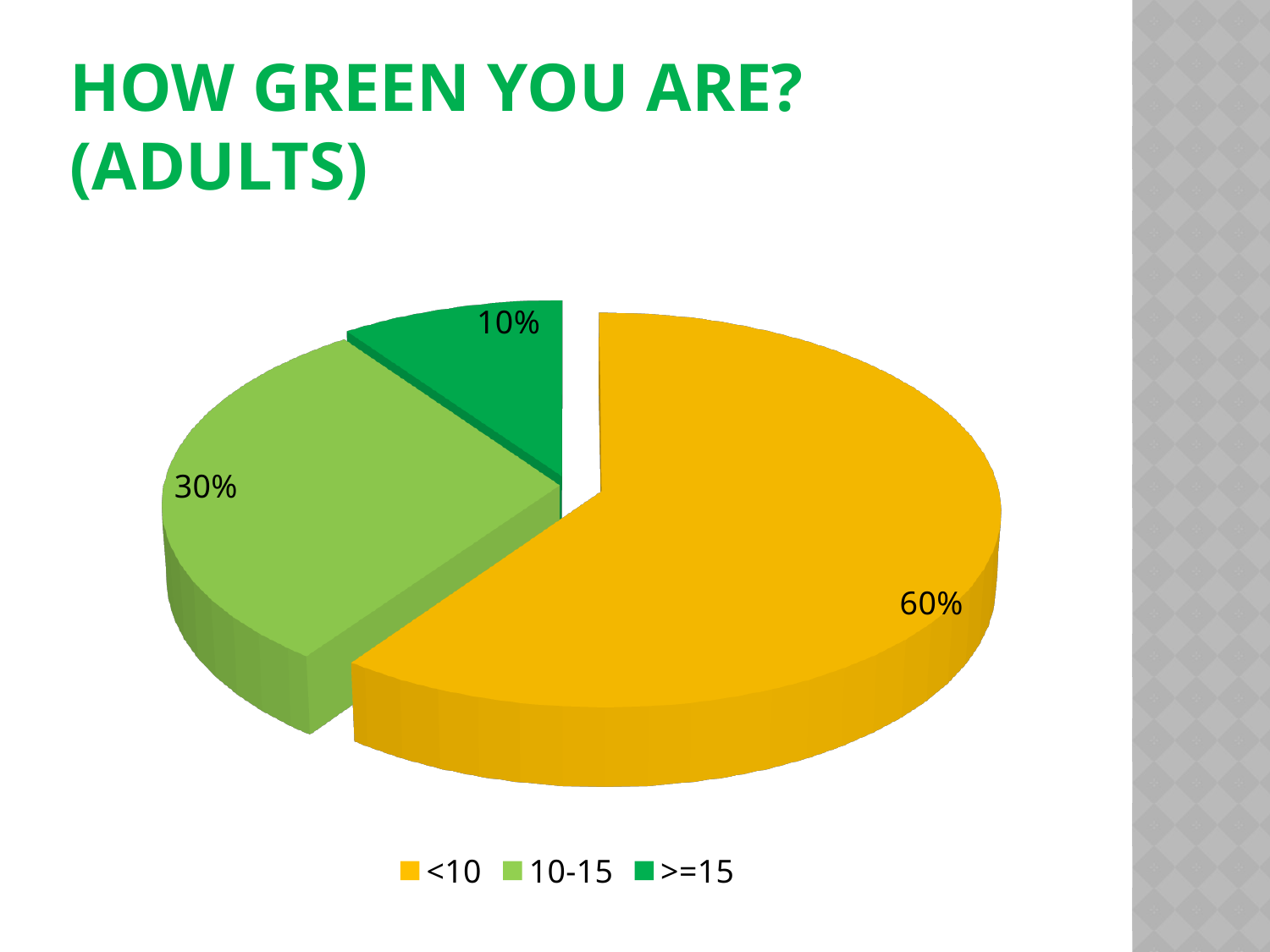
What share of the pie does the "<10" slice represent? 60% How many slices does the pie chart have? 3 What colour is the "<10" slice in the pie chart? yellow/orange Which category has the smallest slice of the pie? >=15 How many entries does the legend list? 3 Which slice is larger, "10-15" or ">=15"? 10-15 What share of the pie does the ">=15" slice represent? 10% What kind of chart is shown on the slide? pie chart What share of the pie does the "10-15" slice represent? 30% What is the difference in percentage points between the "<10" slice and the "10-15" slice? 30% Which category has the largest slice of the pie? <10 What is the difference in percentage points between the "10-15" slice and the ">=15" slice? 20%